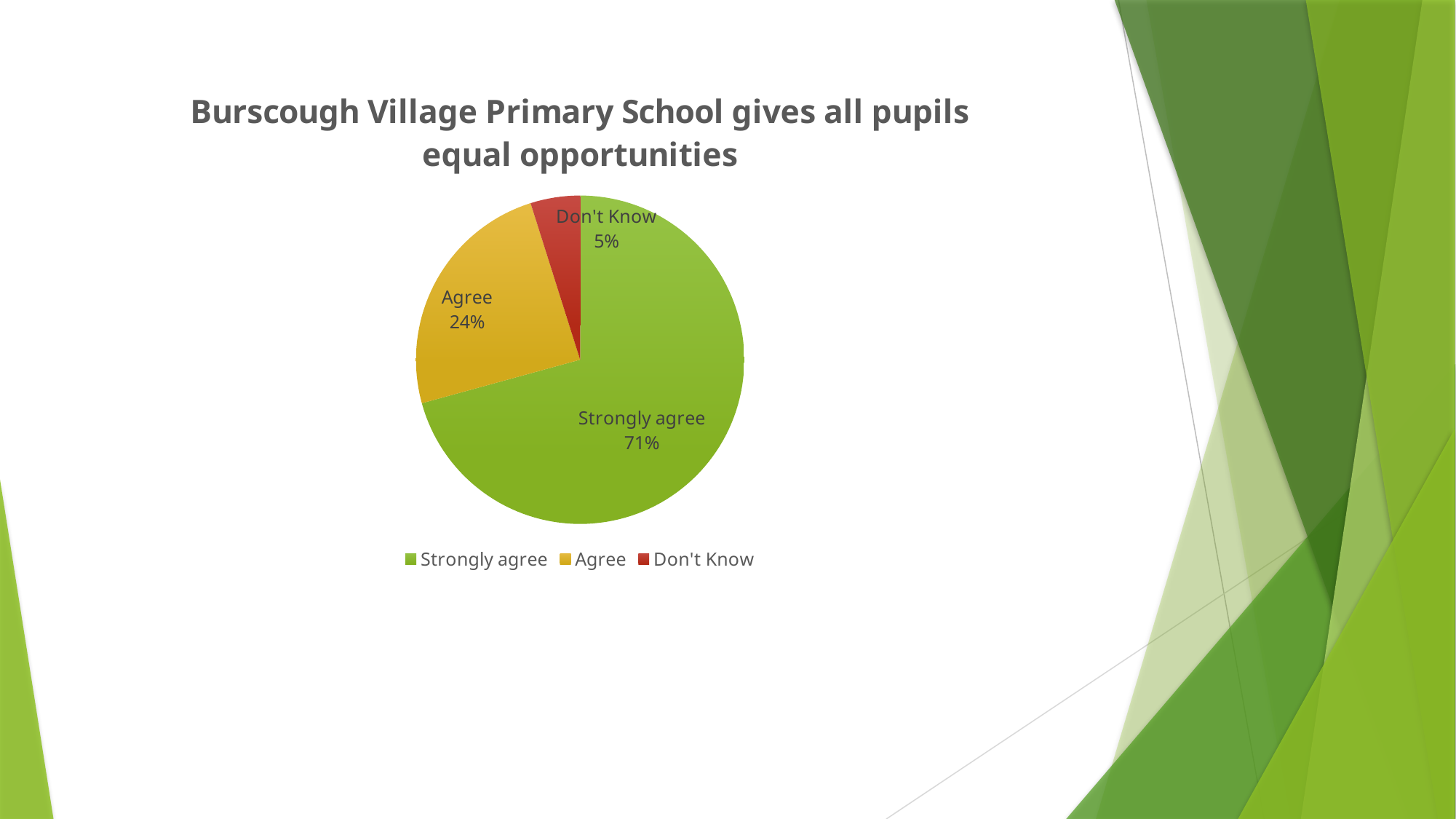
What percentage of respondents chose 'Strongly agree'? 71% Which response has the smallest share of the pie? Don't Know What is the difference in percentage points between 'Agree' and 'Don't Know'? 19 Which is larger, the share for 'Agree' or the share for 'Don't Know'? Agree What is the title of the chart? Burscough Village Primary School gives all pupils equal opportunities What percentage of respondents chose 'Agree'? 24% What percentage of respondents chose 'Don't Know'? 5% Which response has the largest share of the pie? Strongly agree How many entries does the legend list? 3 What kind of chart is shown on the slide? pie chart What is the difference in percentage points between 'Strongly agree' and 'Agree'? 47 How many slices does the pie chart have? 3